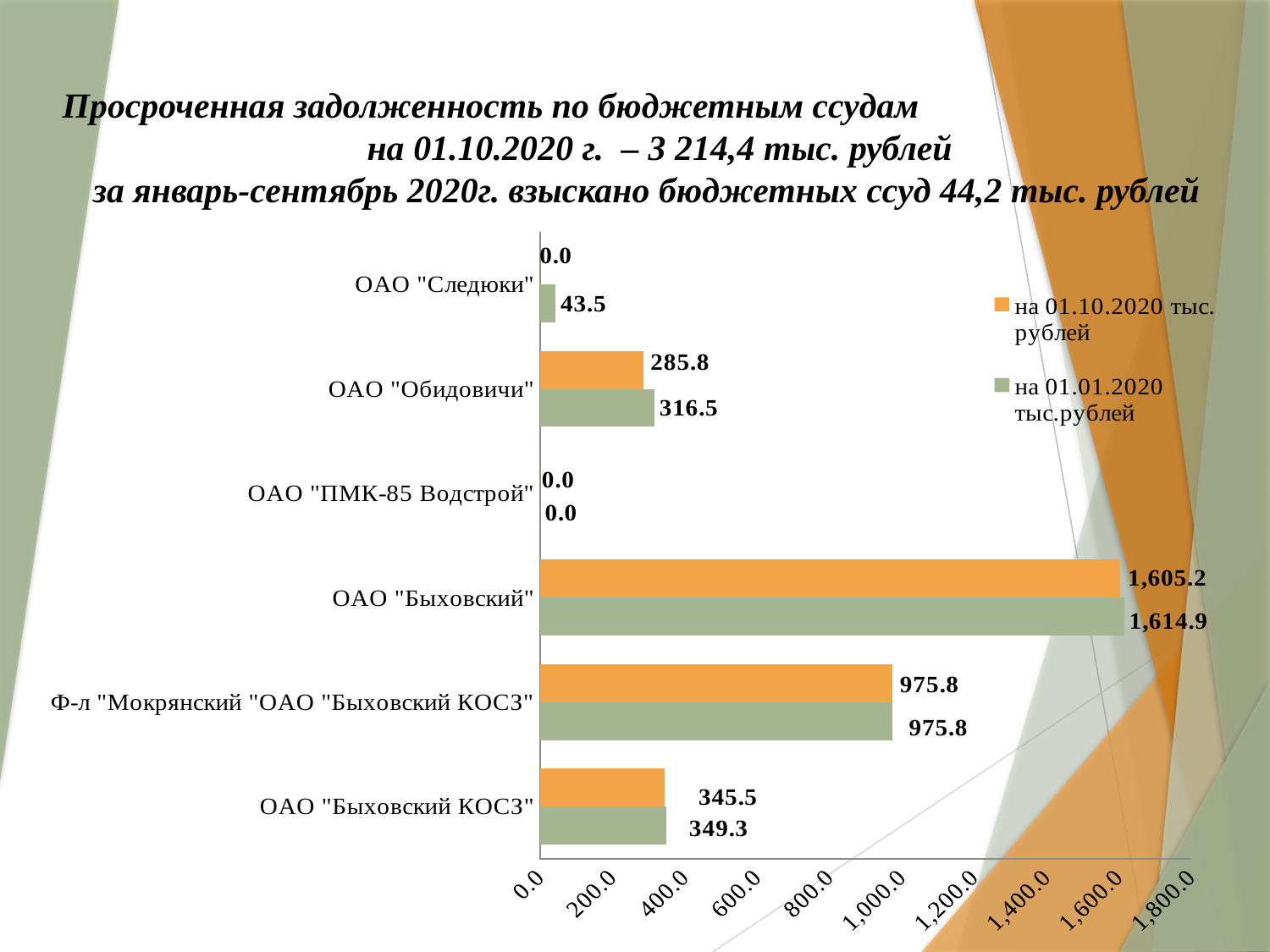
What kind of chart is shown on the slide? bar chart How many series does the legend list? 2 Which organisation has a value of 0.0 in both series? ОАО "ПМК-85 Водстрой" How many organisations (categories) are shown on the chart? 6 Which is larger for ОАО "Быховский КОСЗ": the value on 01.10.2020 or the value on 01.01.2020? на 01.01.2020 (349.3) What is the value for ОАО "Быховский" in the series "на 01.10.2020 тыс. рублей"? 1,605.2 Which colour represents the series "на 01.10.2020 тыс. рублей" in the legend? orange Which organisation has the highest value in the series "на 01.10.2020 тыс. рублей"? ОАО "Быховский" What is the difference between the two series values for ОАО "Обидовичи" (316.5 minus 285.8)? 30.7 Is the value for Ф-л "Мокрянский" ОАО "Быховский КОСЗ" on 01.10.2020 greater or less than 800.0? greater What is the value for ОАО "Обидовичи" in the series "на 01.01.2020 тыс.рублей"? 316.5 What is the value for ОАО "Следюки" in the series "на 01.01.2020 тыс.рублей"? 43.5